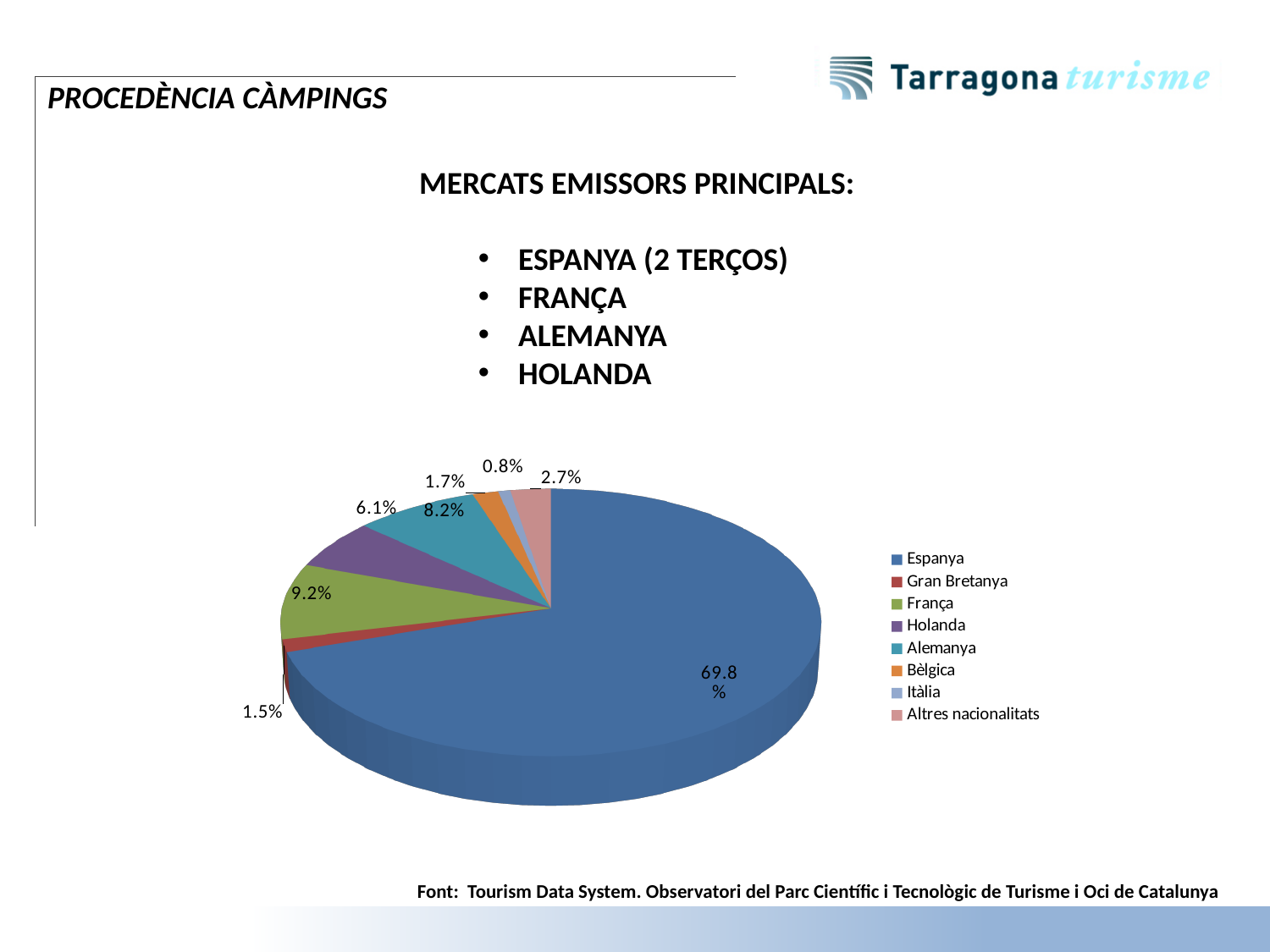
Which category has the smallest slice of the pie? Itàlia What is the value shown for Holanda? 6.1% What is the value shown for Itàlia? 0.8% What is the value shown for Alemanya? 8.2% What is the difference between the shares of França and Alemanya? 1.0% What share of the pie does Espanya hold? 69.8% What colour is the slice for Altres nacionalitats? Pink Which category has the largest slice of the pie? Espanya How many categories does the legend list? 8 What is the value shown for França? 9.2% Which is larger, the share for Bèlgica or the share for Gran Bretanya? Bèlgica What kind of chart is shown on the slide? Pie chart